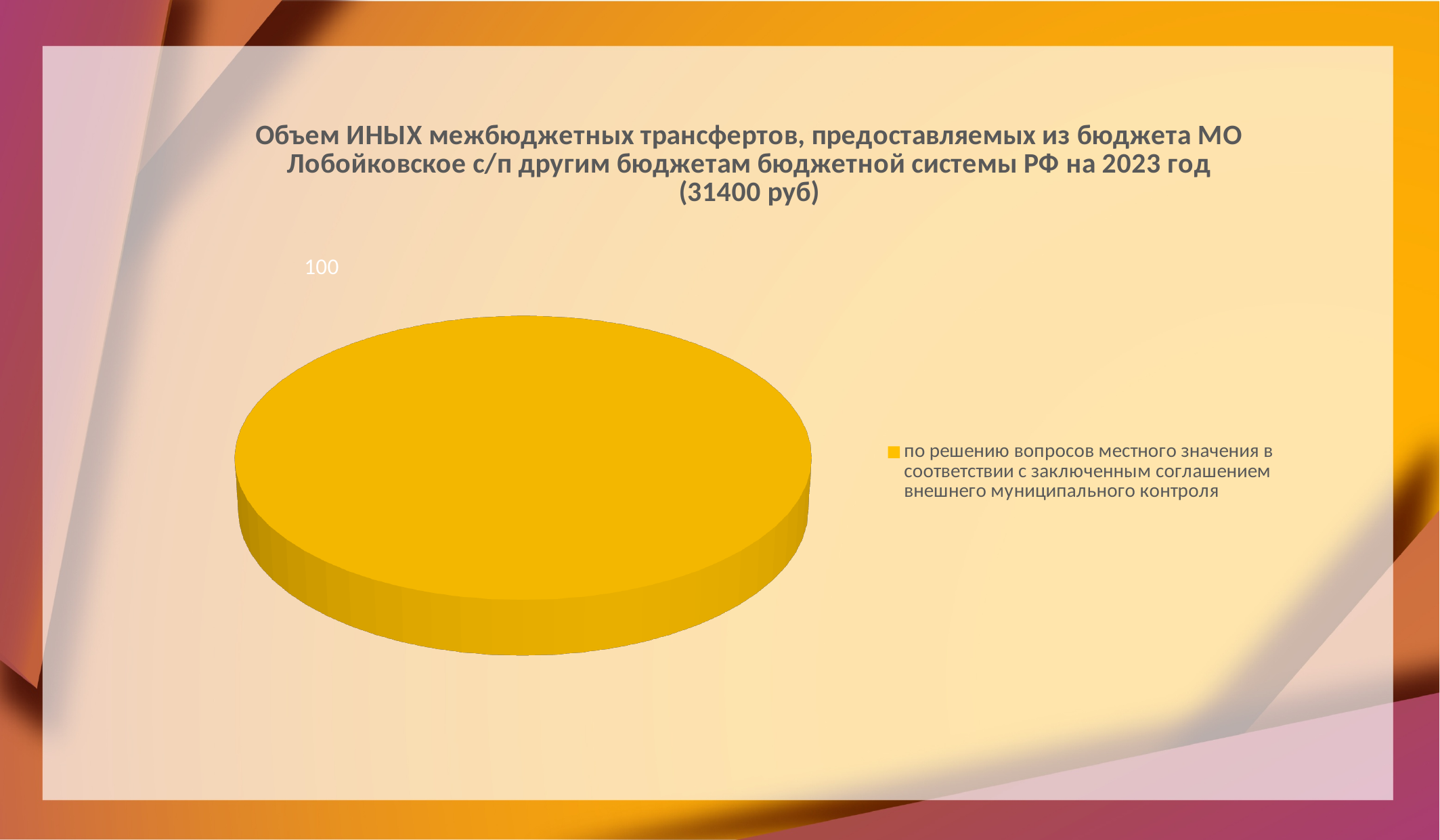
What total amount in rubles is stated in the chart title? 31400 руб What value is printed as the data label on the pie chart? 100 What kind of chart is shown on the slide? pie chart What colour is the slice of the pie chart? yellow What share of the pie does the single slice occupy? 100% How many entries does the legend of the pie chart list? 1 What is the value shown for the slice "по решению вопросов местного значения в соответствии с заключенным соглашением внешнего муниципального контроля"? 100 How many slices does the pie chart have? 1